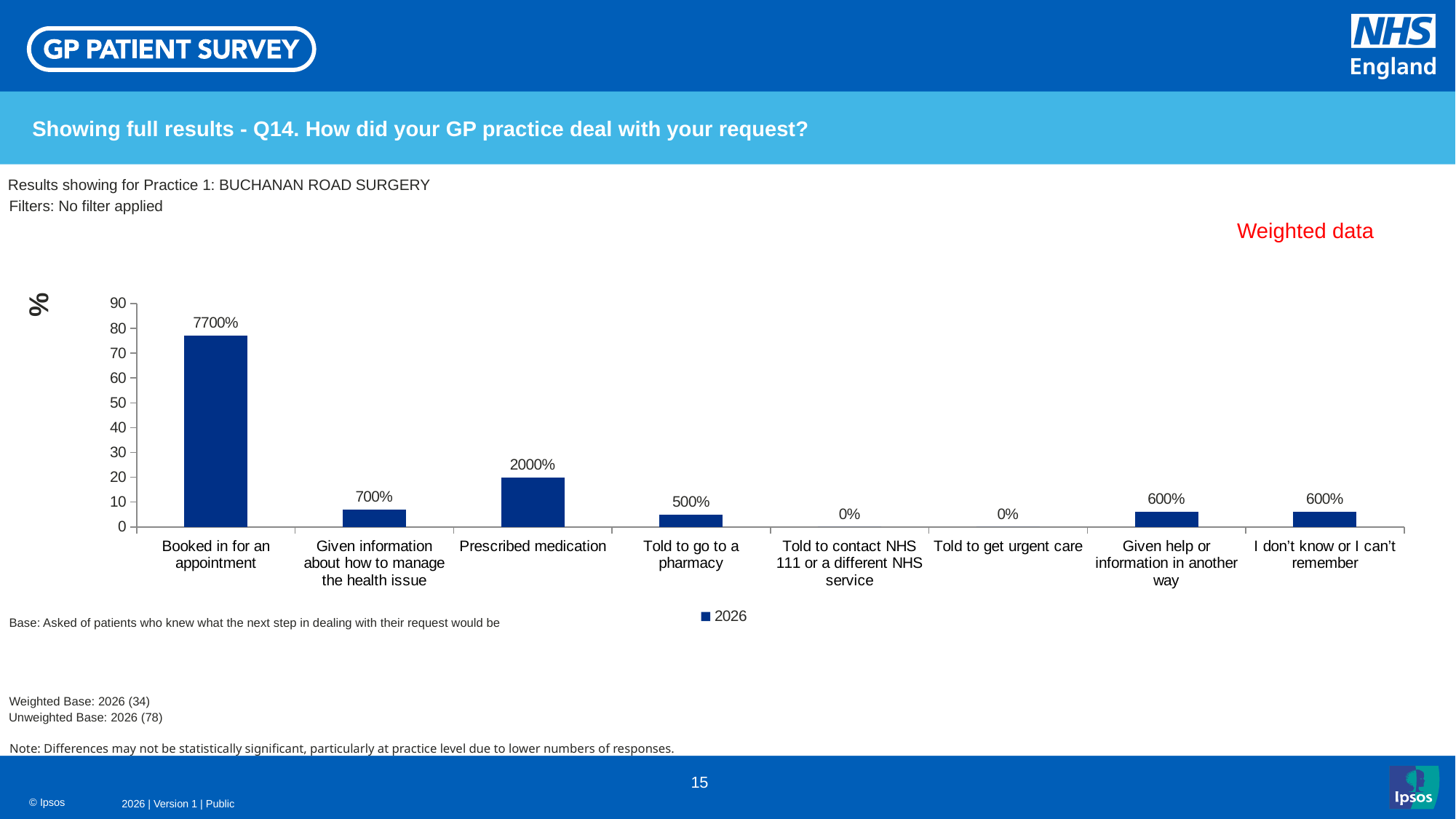
How many categories are shown on the x axis of the chart? 8 What is the data label shown for 'Booked in for an appointment'? 7700% How many series does the legend list? 1 What is the data label shown for 'Prescribed medication'? 2000% Is the bar for 'Booked in for an appointment' greater or less than 70 on the axis? greater What kind of chart is shown on the slide? Bar chart Which category has the highest value in the chart? Booked in for an appointment What is the data label shown for 'Told to go to a pharmacy'? 500% Which is larger: the value for 'Prescribed medication' or for 'Told to go to a pharmacy'? Prescribed medication Which categories show a value of 0%? Told to contact NHS 111 or a different NHS service; Told to get urgent care Is the bar for 'Given information about how to manage the health issue' greater or less than 10 on the axis? less What is the data label shown for 'Given help or information in another way'? 600%